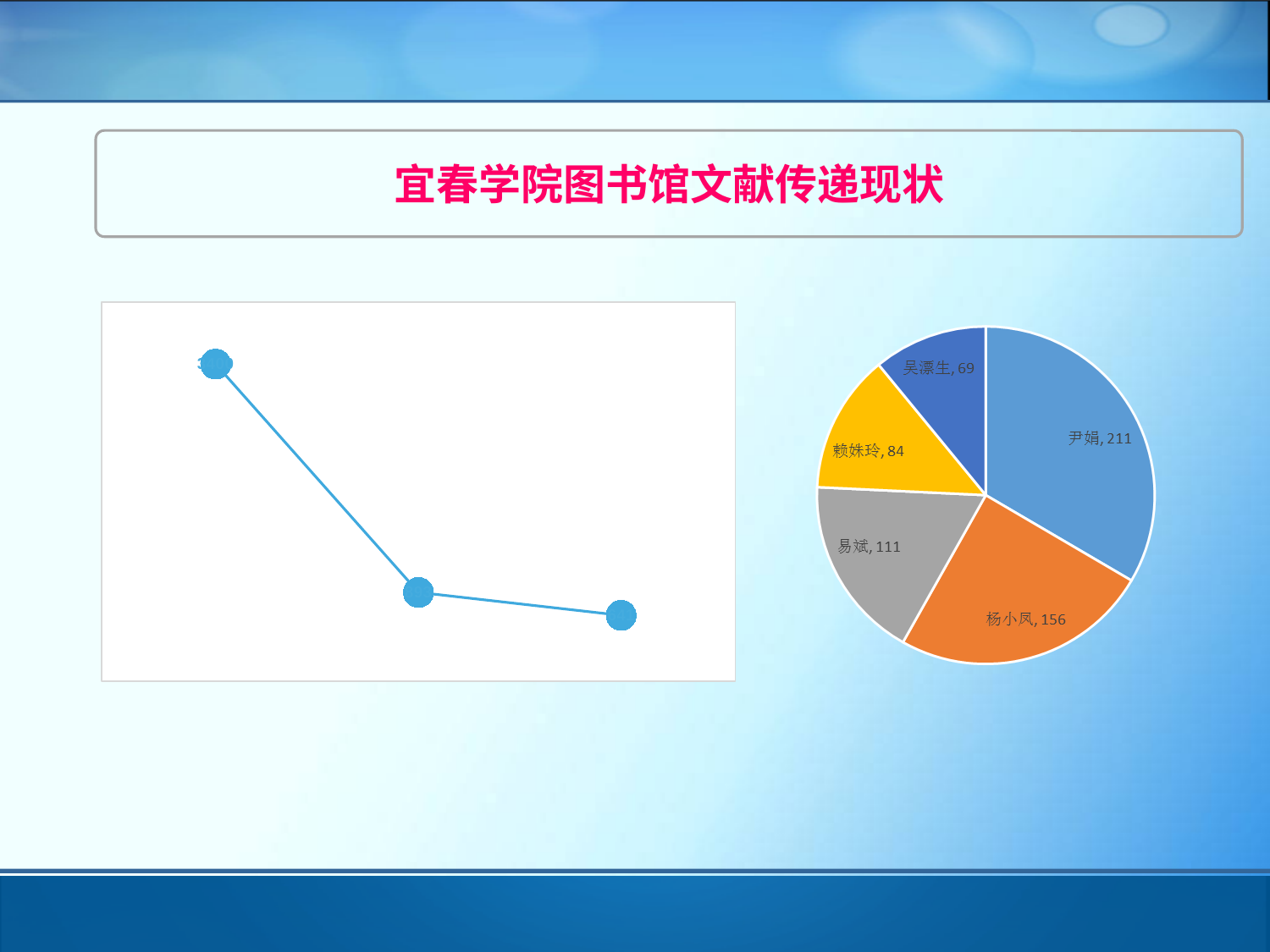
What kind of chart is the chart on the right of the slide? pie chart Do the values on the line chart on the left of the slide rise or fall from left to right? fall In the pie chart on the right, which person has the smallest value? 吴漂生 In the pie chart on the right, which is larger, the value for 易斌 or the value for 赖姝玲? 易斌 In the pie chart on the right, what is the difference between the values for 尹娟 and 杨小凤? 55 In the pie chart on the right, what is the value for 杨小凤? 156 How many data points are plotted on the line chart on the left of the slide? 3 In the pie chart on the right, which person has the largest value? 尹娟 What kind of chart is the chart on the left of the slide? line chart How many slices does the pie chart on the right of the slide have? 5 In the pie chart on the right, what is the value for 赖姝玲? 84 In the pie chart on the right, what is the value for 尹娟? 211